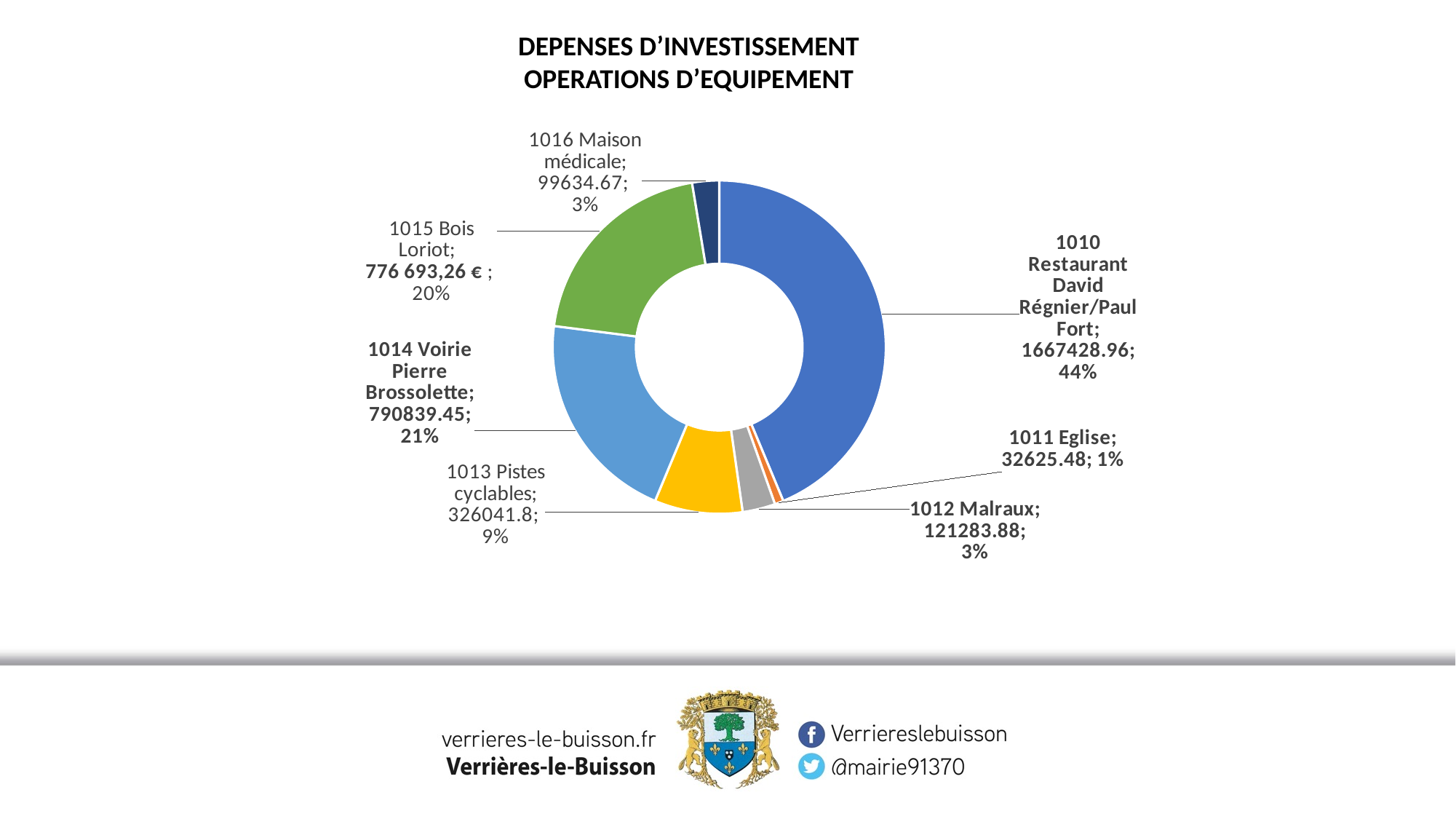
What is the value for 1013 Pistes cyclables? 326041.8 Which category has the largest value? 1010 Restaurant David Régnier/Paul Fort What share of the chart does 1014 Voirie Pierre Brossolette represent? 21% What is the value for 1011 Eglise? 32625.48 What kind of chart is shown on the slide? Doughnut (pie) chart What is the value for 1010 Restaurant David Régnier/Paul Fort? 1667428.96 What is the title of the chart? DEPENSES D'INVESTISSEMENT OPERATIONS D'EQUIPEMENT What is the value for 1016 Maison médicale? 99634.67 What share of the chart does 1015 Bois Loriot represent? 20% Which category has the smallest value? 1011 Eglise Which is larger, the value for 1012 Malraux or the value for 1016 Maison médicale? 1012 Malraux How many categories are shown in the chart? 7